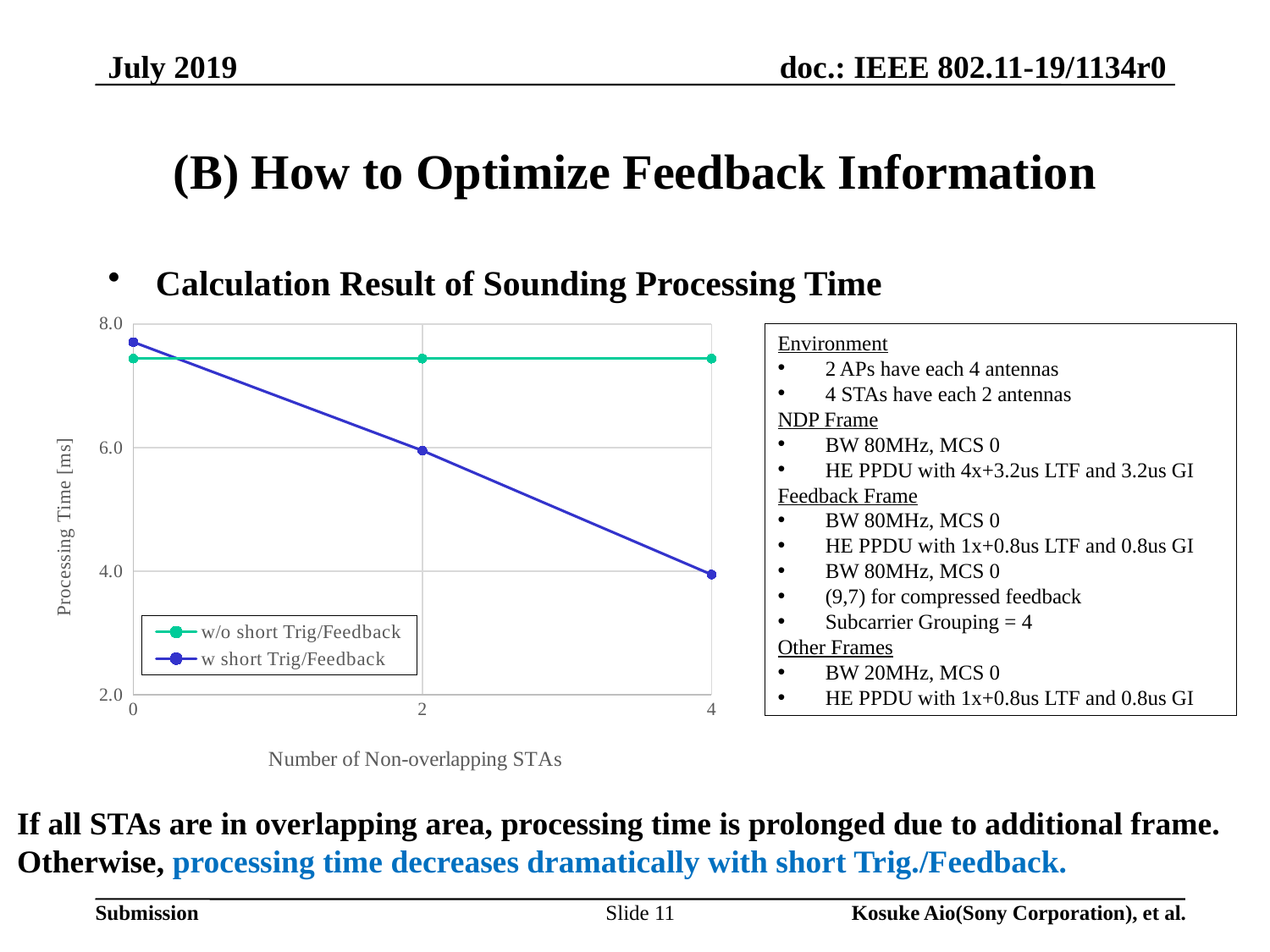
At 0 non-overlapping STAs, which series has the higher processing time? w short Trig/Feedback Does the processing time for 'w short Trig/Feedback' rise or fall as the number of non-overlapping STAs increases? fall What is the label of the x axis of the chart? Number of Non-overlapping STAs What kind of chart is shown on the slide? line chart Is the processing time for 'w short Trig/Feedback' at 2 non-overlapping STAs greater or less than 4.0 ms? greater What is the label of the y axis of the chart? Processing Time [ms] Does the processing time for 'w/o short Trig/Feedback' rise, fall, or stay flat as the number of non-overlapping STAs increases? stay flat Is the processing time for 'w short Trig/Feedback' at 4 non-overlapping STAs greater or less than 6.0 ms? less How many data points are plotted for the 'w short Trig/Feedback' series? 3 At 4 non-overlapping STAs, which series has the higher processing time? w/o short Trig/Feedback Is the processing time for 'w/o short Trig/Feedback' at 4 non-overlapping STAs greater or less than 6.0 ms? greater How many series does the chart legend list? 2